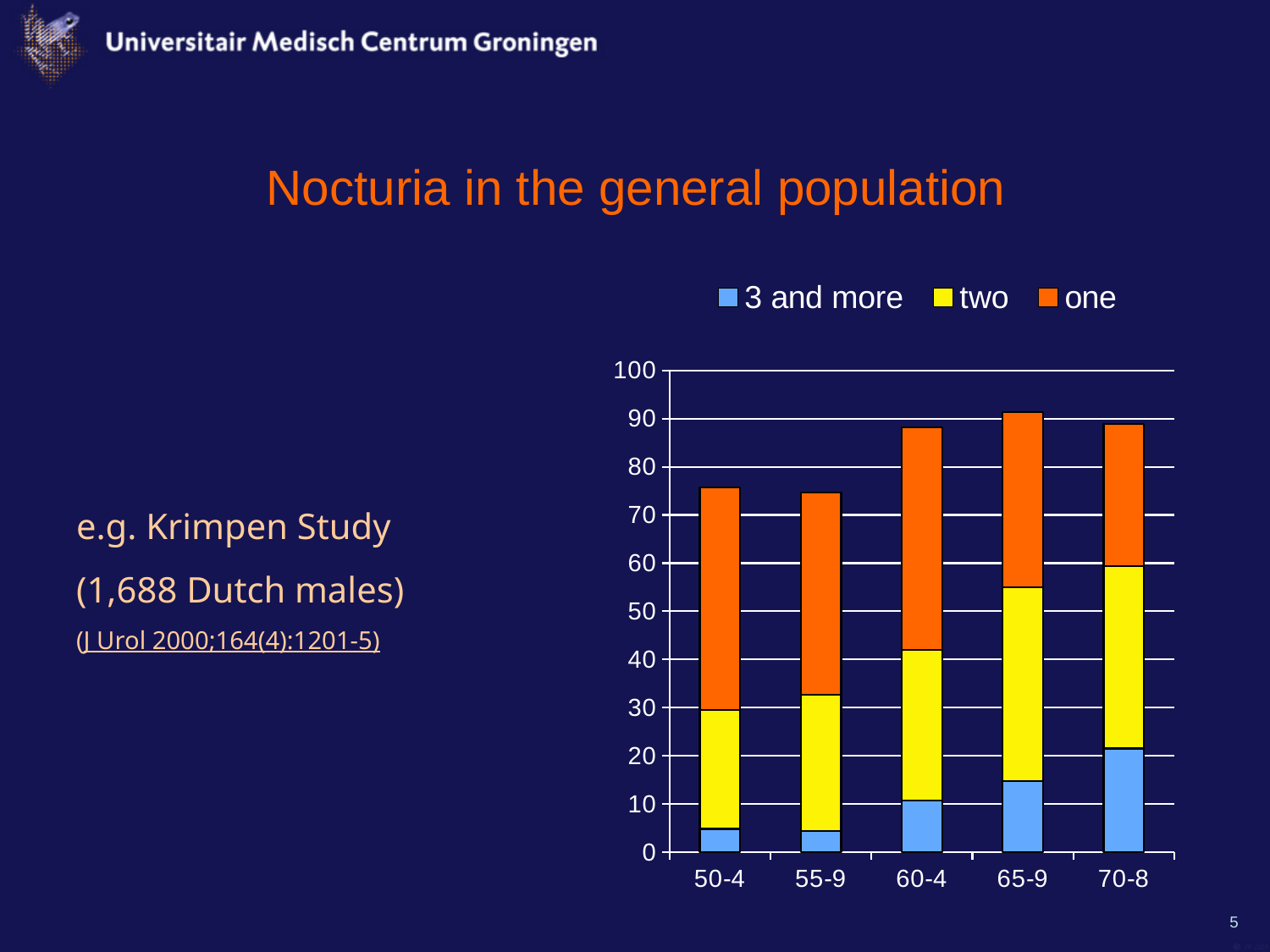
How many age-group categories are shown on the x axis of the chart? 5 Which colour represents the 'one' series in the chart's legend? orange What is the title of the slide containing the chart? Nocturia in the general population Is the total stacked bar for the 50-4 age group greater or less than 80? less Does the '3 and more' segment rise or fall as the age groups increase from 50-4 to 70-8? rise How many series does the chart's legend list? 3 Which is larger, the 'two' segment for 70-8 or for 50-4? 70-8 What kind of chart is shown on the slide? stacked bar chart Is the '3 and more' value for the 70-8 age group greater or less than 10? greater Is the total stacked bar for the 60-4 age group greater or less than 80? greater Which age group has the tallest '3 and more' segment in the chart? 70-8 Which is larger, the '3 and more' segment for 65-9 or for 60-4? 65-9